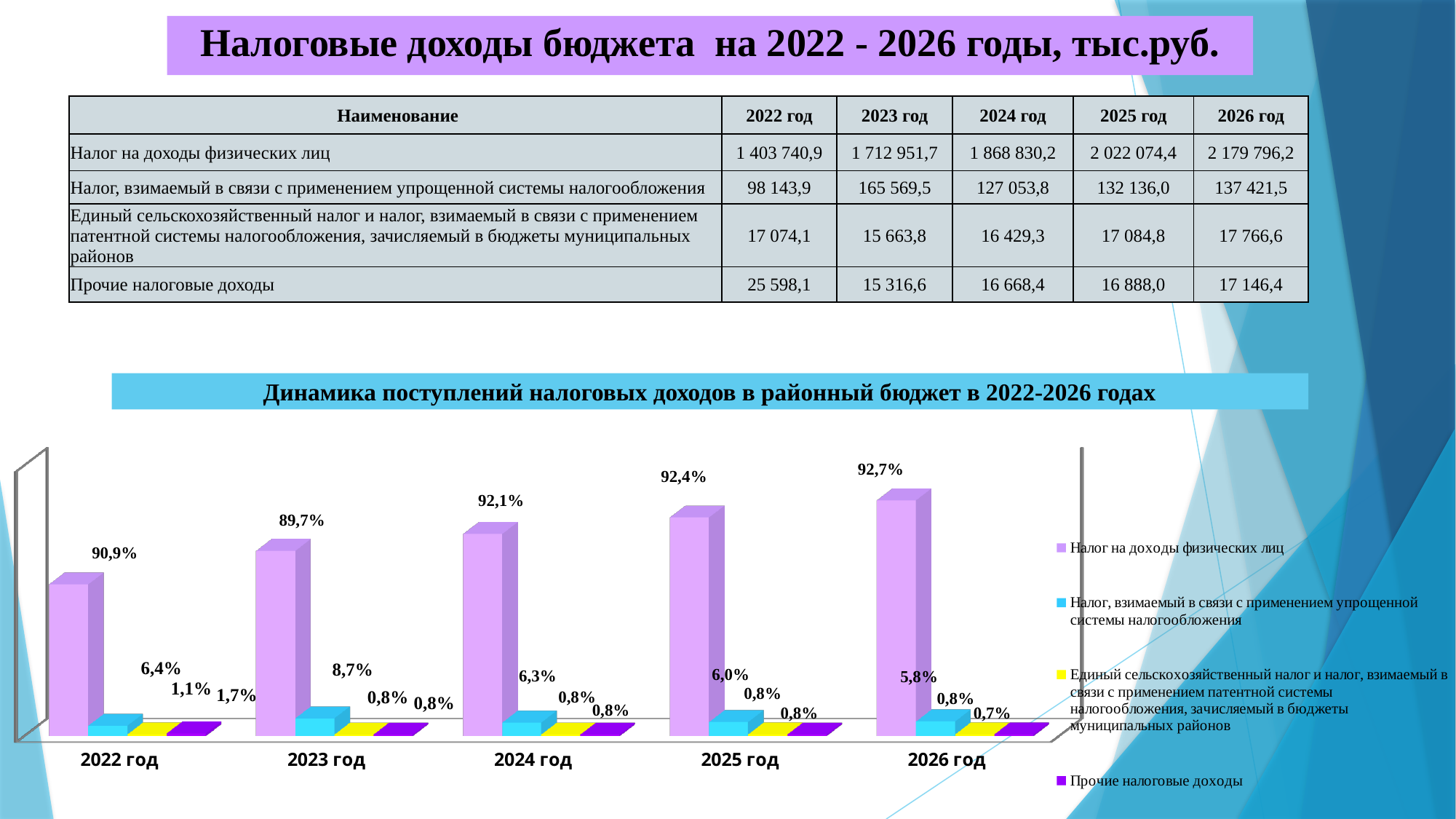
What is the value for 'Прочие налоговые доходы' in 2026 год on the chart? 0,7% What colour represents 'Налог на доходы физических лиц' in the chart legend? Purple (lilac) How many year categories are shown on the x axis of the chart? 5 What type of chart is shown under the heading 'Динамика поступлений налоговых доходов в районный бюджет в 2022-2026 годах'? Bar chart How many series does the chart legend list? 4 What is the value for 'Налог на доходы физических лиц' in 2022 год on the chart? 90,9% Which is larger on the chart: the 'Налог, взимаемый в связи с применением упрощенной системы налогообложения' value for 2023 год or for 2026 год? 2023 год Does the value for 'Налог, взимаемый в связи с применением упрощенной системы налогообложения' rise or fall from 2023 год to 2026 год on the chart? Fall What is the value for 'Налог, взимаемый в связи с применением упрощенной системы налогообложения' in 2023 год on the chart? 8,7% In which year is the value for 'Налог на доходы физических лиц' highest on the chart? 2026 год What is the difference between the 'Налог на доходы физических лиц' values for 2026 год and 2022 год on the chart? 1,8%